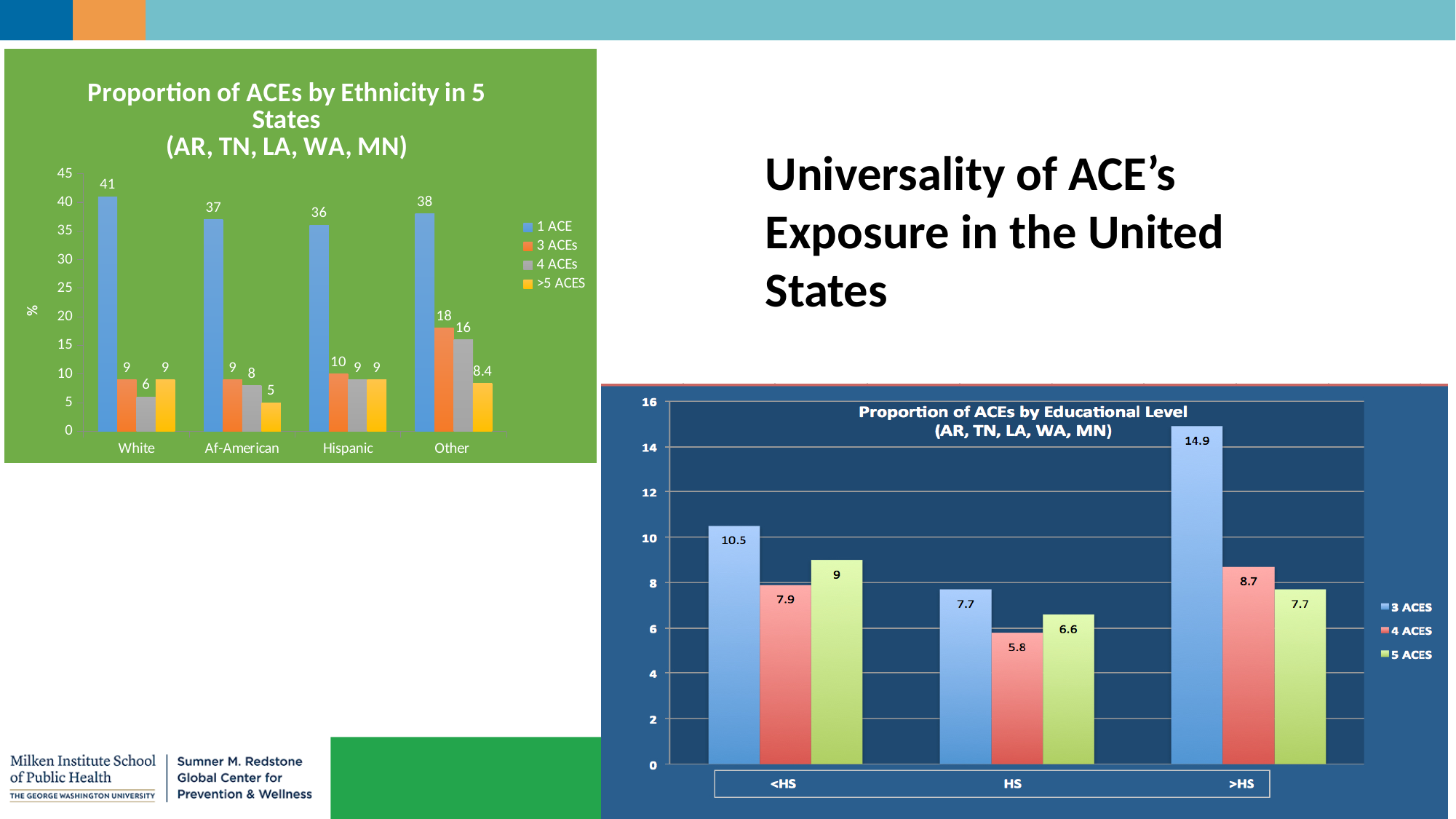
In the 'Proportion of ACEs by Ethnicity in 5 States' chart, what is the difference between the 3 ACEs value for Other and the 3 ACEs value for Hispanic? 8 In the 'Proportion of ACEs by Educational Level' chart, which is larger: the 4 ACES value for <HS or the 4 ACES value for >HS? >HS In the 'Proportion of ACEs by Educational Level' chart, which educational level has the lowest value for 5 ACES? HS In the 'Proportion of ACEs by Ethnicity in 5 States' chart, how many series does the legend list? 4 In the 'Proportion of ACEs by Ethnicity in 5 States' chart, what is the value for >5 ACES for Other? 8.4 In the 'Proportion of ACEs by Ethnicity in 5 States' chart, which ethnicity has the highest value for 1 ACE? White In the 'Proportion of ACEs by Ethnicity in 5 States' chart, what is the value for 1 ACE for White? 41 What kind of chart is the 'Proportion of ACEs by Educational Level' chart? Bar chart In the 'Proportion of ACEs by Educational Level' chart, what is the value for 3 ACES for >HS? 14.9 In the 'Proportion of ACEs by Educational Level' chart, how many educational level categories are shown? 3 In the 'Proportion of ACEs by Educational Level' chart, what is the value for 4 ACES for HS? 5.8 In the 'Proportion of ACEs by Ethnicity in 5 States' chart, which ethnicity has the lowest value for >5 ACES? Af-American